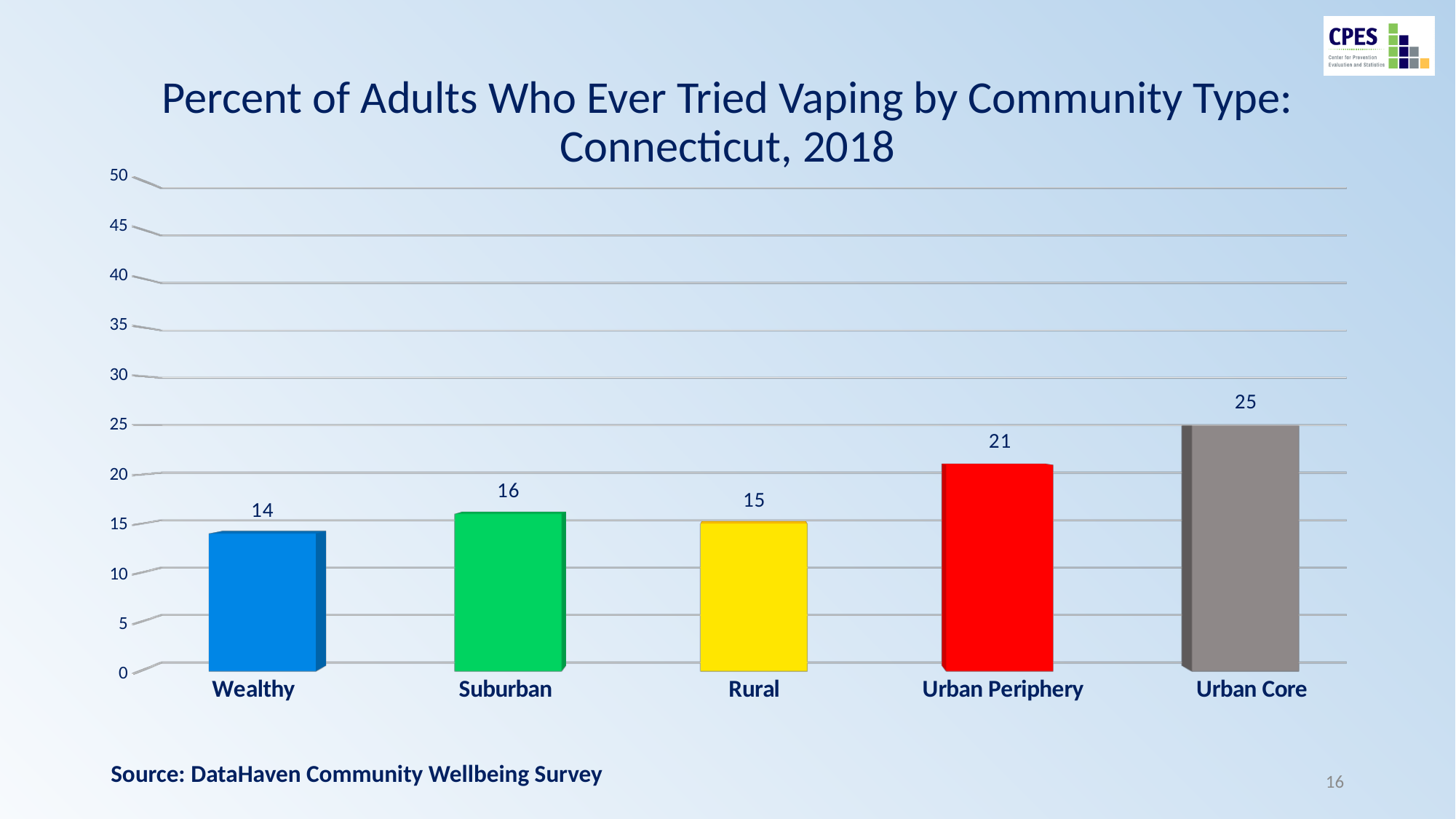
What kind of chart is shown on the slide? bar chart What is the title of the chart? Percent of Adults Who Ever Tried Vaping by Community Type: Connecticut, 2018 What is the value for Urban Periphery? 21 What is the difference between the values for Urban Periphery and Suburban? 5 What is the value for Wealthy? 14 What is the difference between the values for Urban Core and Wealthy? 11 Which community type has the lowest value? Wealthy What is the value for Rural? 15 Is the value for Urban Core greater or less than 20? greater Which is larger, the value for Suburban or the value for Rural? Suburban How many community types are shown on the chart? 5 Which community type has the highest value? Urban Core